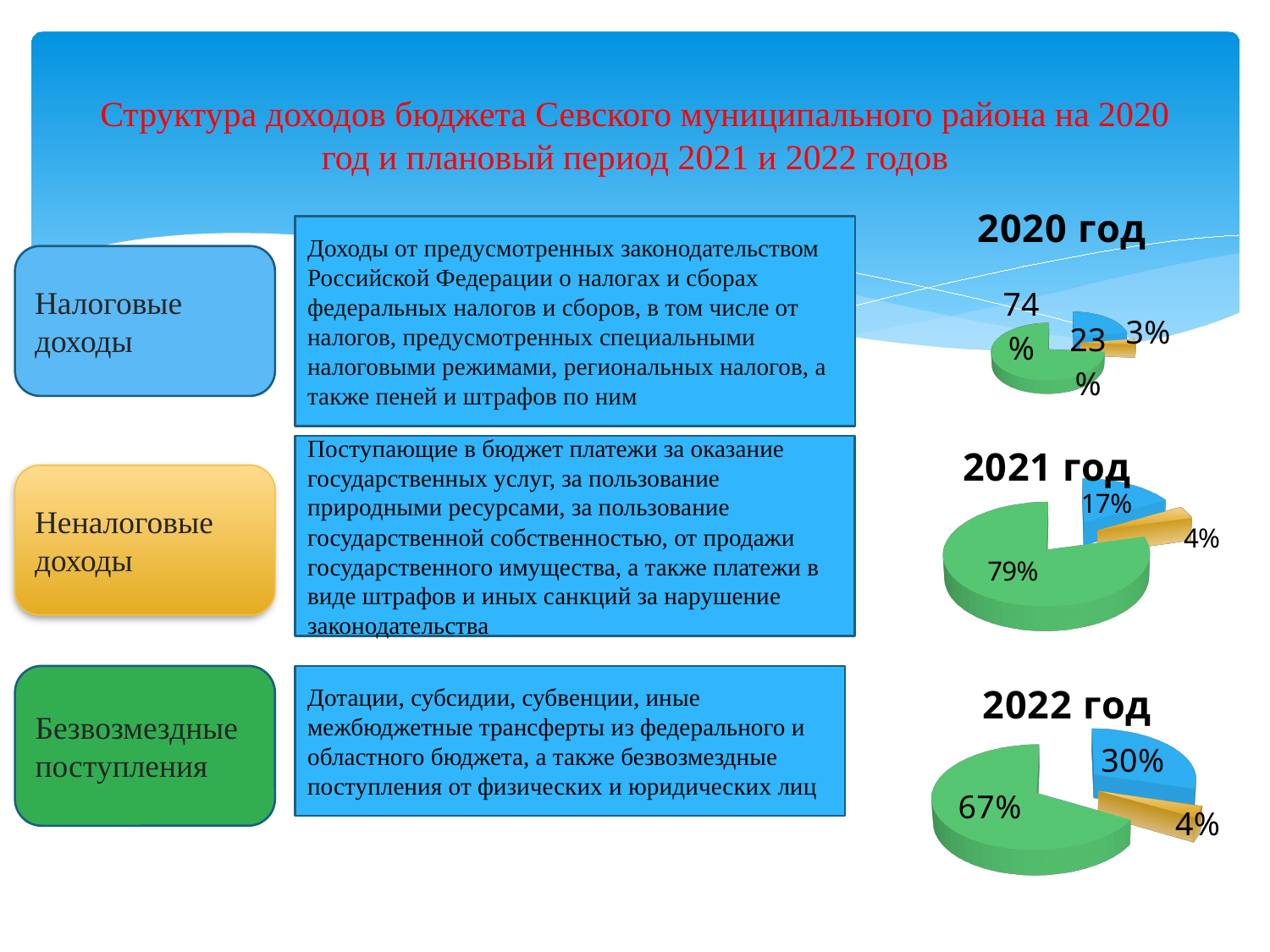
In the 2022 год pie chart, what is the value of the largest slice? 67% In the 2020 год pie chart, what is the value of the largest slice? 74% In the 2022 год pie chart, what is the difference between the green slice and the blue slice? 37 percentage points In the 2021 год pie chart, what share does the yellow slice have? 4% Which is larger: the blue slice in the 2021 год chart or the blue slice in the 2022 год chart? 2022 год In the 2020 год pie chart, what is the value of the smallest slice? 3% In the 2021 год pie chart, what share does the green slice have? 79% In the 2022 год pie chart, what share does the blue slice have? 30% How many pie charts are shown on the slide? 3 What kind of chart is used for the 2020 год chart? pie chart In the 2020 год pie chart, what share does the blue slice have? 23% How many slices does the 2020 год pie chart have? 3